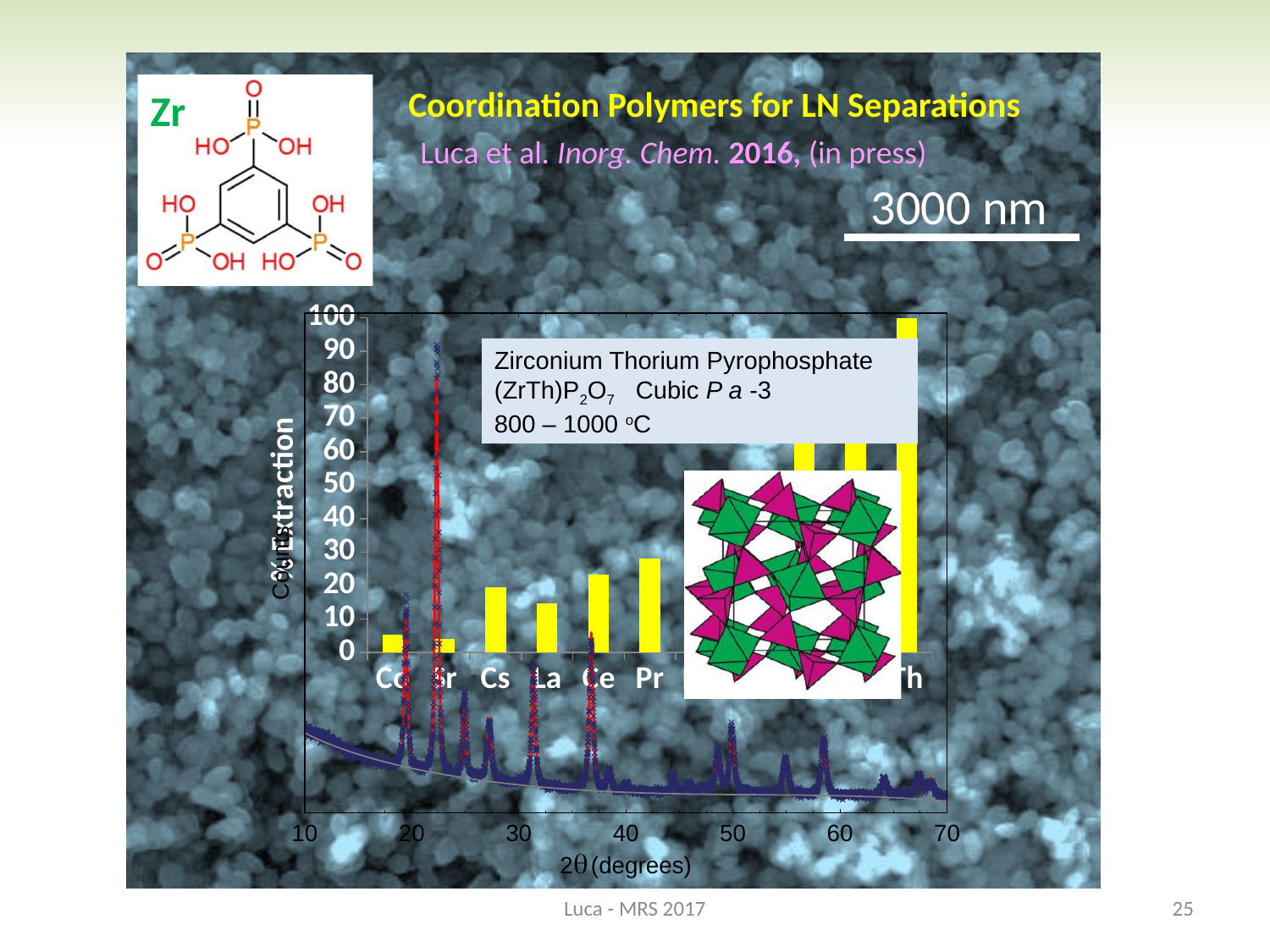
In the '% Extraction' bar chart, is the value for Co greater or less than 10? less In the '% Extraction' bar chart, which is larger, the value for Pr or the value for Cs? Pr What is the y-axis label of the yellow bar chart? % Extraction In the '% Extraction' bar chart, which is larger, the value for Cs or the value for La? Cs In the '% Extraction' bar chart, is the value for La greater or less than 20? less In the '% Extraction' bar chart, which is larger, the value for Ce or the value for Sr? Ce In the '% Extraction' bar chart, which labelled element has the highest extraction? Th In the '% Extraction' bar chart, is the value for Pr greater or less than 20? greater What is the x-axis label of the diffraction pattern chart at the bottom of the slide? 2θ (degrees) What kind of chart is the yellow-bar chart labelled '% Extraction'? bar chart